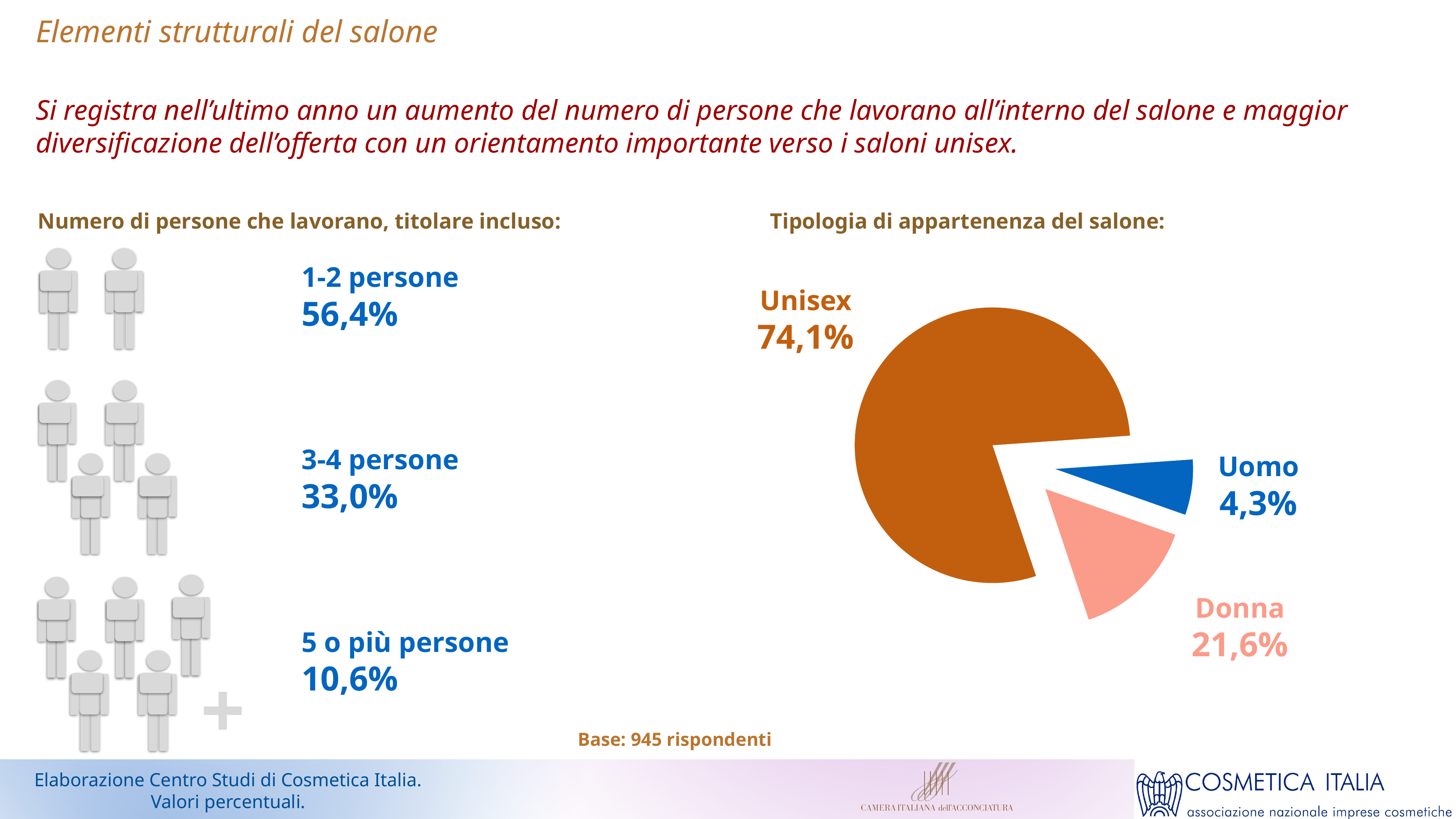
In the pie chart "Tipologia di appartenenza del salone", how many slices are there? 3 In the pie chart "Tipologia di appartenenza del salone", what is the difference between the Donna and Uomo values? 17,3% In the pie chart "Tipologia di appartenenza del salone", which category has the largest slice? Unisex What kind of chart is shown under "Tipologia di appartenenza del salone"? pie chart In the pie chart "Tipologia di appartenenza del salone", which is larger, Donna or Uomo? Donna In the pie chart "Tipologia di appartenenza del salone", what is the value for Unisex? 74,1% In the left-hand graphic "Numero di persone che lavorano, titolare incluso", which category has the highest value? 1-2 persone In the pie chart "Tipologia di appartenenza del salone", what colour is the Unisex slice? orange In the pie chart "Tipologia di appartenenza del salone", which category has the smallest slice? Uomo In the pie chart "Tipologia di appartenenza del salone", what is the value for Donna? 21,6% In the left-hand graphic "Numero di persone che lavorano, titolare incluso", what is the value for 3-4 persone? 33,0% In the pie chart "Tipologia di appartenenza del salone", what is the value for Uomo? 4,3%